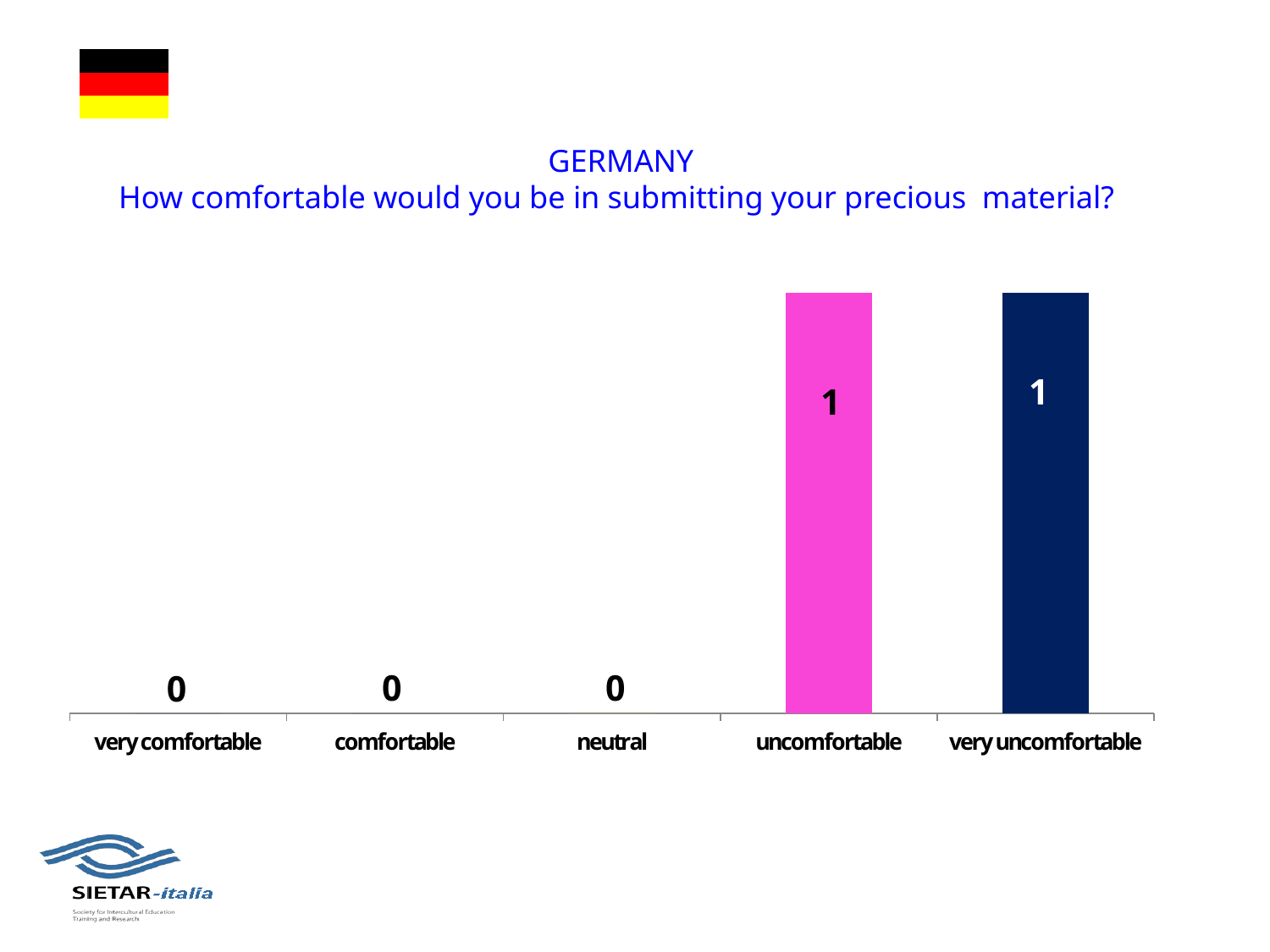
What is the value for "uncomfortable"? 1 Which is larger, the value for "uncomfortable" or the value for "neutral"? uncomfortable What is the difference between the value for "very uncomfortable" and the value for "comfortable"? 1 What is the value for "comfortable"? 0 What is the value for "very comfortable"? 0 What is the total of all the values shown in the chart? 2 What kind of chart is shown on the slide? bar chart What is the value for "very uncomfortable"? 1 How many categories are shown on the x axis? 5 How many categories have a value of 0? 3 Which country is named in the chart title? GERMANY What is the value for "neutral"? 0